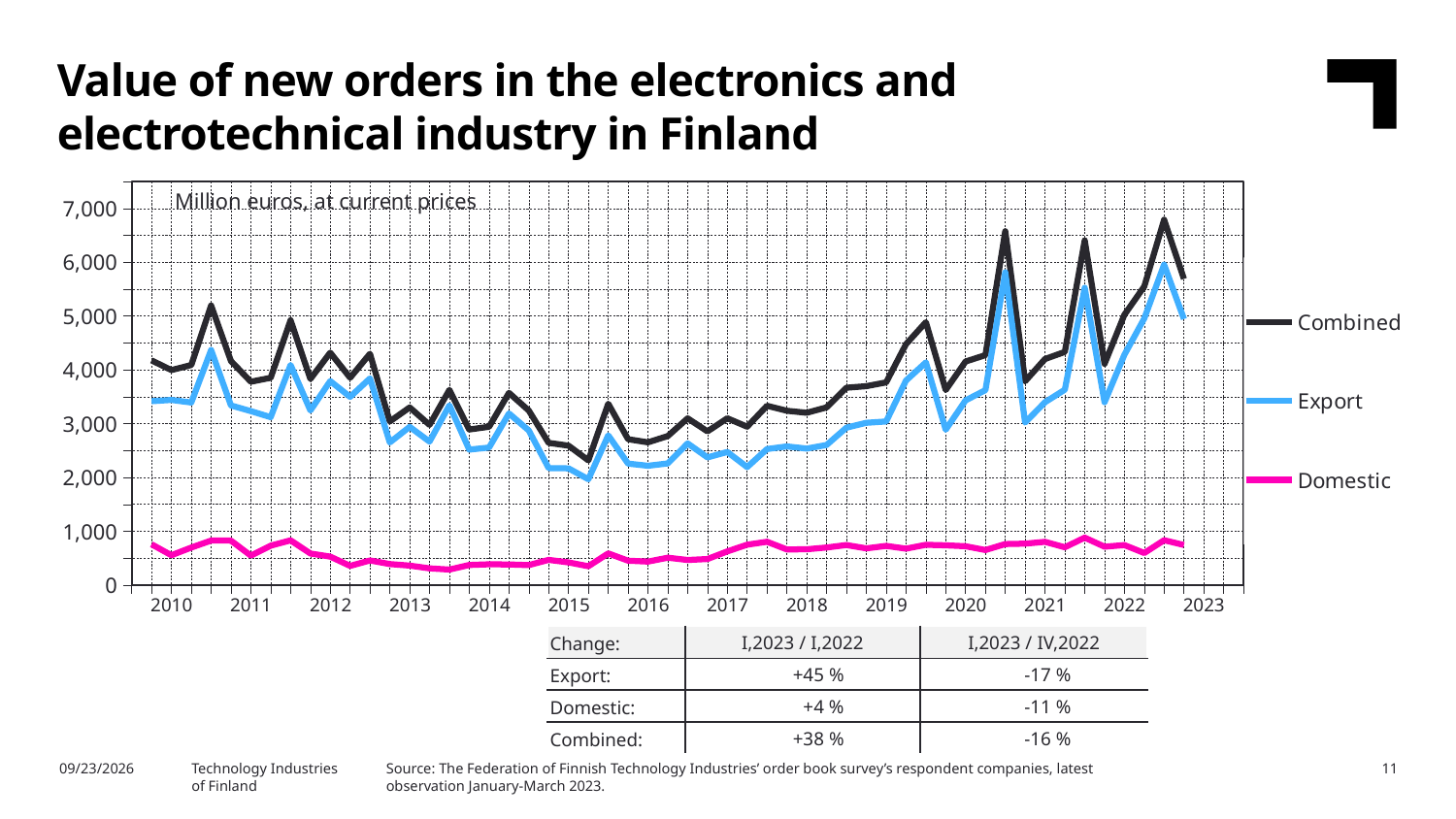
What colour is the Domestic line in the legend? Pink Is the peak value for Export in 2020 greater or less than 5,000? greater Do the Export values generally rise or fall from 2015 to 2022? rise How many series does the legend list? 3 Is the peak value for Combined in 2022 greater or less than 6,000? greater What kind of chart is shown on the slide? Line chart What unit is stated at the top of the chart? Million euros, at current prices Which is larger in 2018, the Export value or the Domestic value? Export Is the value for Domestic in 2015 greater or less than 1,000? less Which series has the highest values throughout the chart? Combined Which series has the lowest values throughout the chart? Domestic